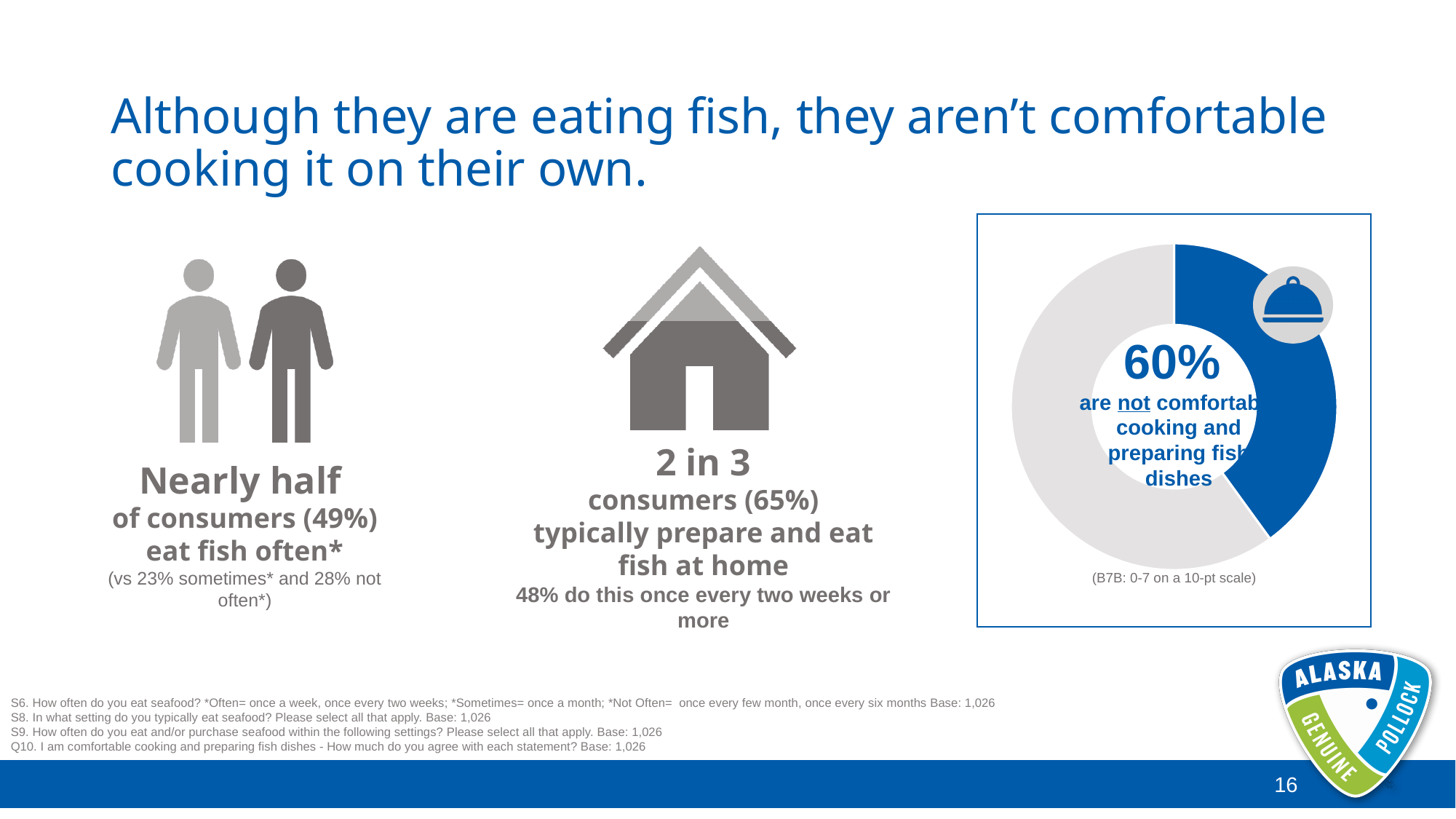
What colour is the slice representing the 60% in the pie chart on the right? grey In the pie chart on the right, what percentage of consumers are not comfortable cooking and preparing fish dishes? 60% What scale note is printed beneath the pie chart on the right? (B7B: 0-7 on a 10-pt scale) How many slices does the pie chart on the right have? 2 In the pie chart on the right, is the blue slice larger or smaller than the grey slice? smaller In the pie chart on the right, is the share of consumers who are not comfortable cooking fish greater or less than 50%? greater What kind of chart is shown in the box on the right of the slide? doughnut chart